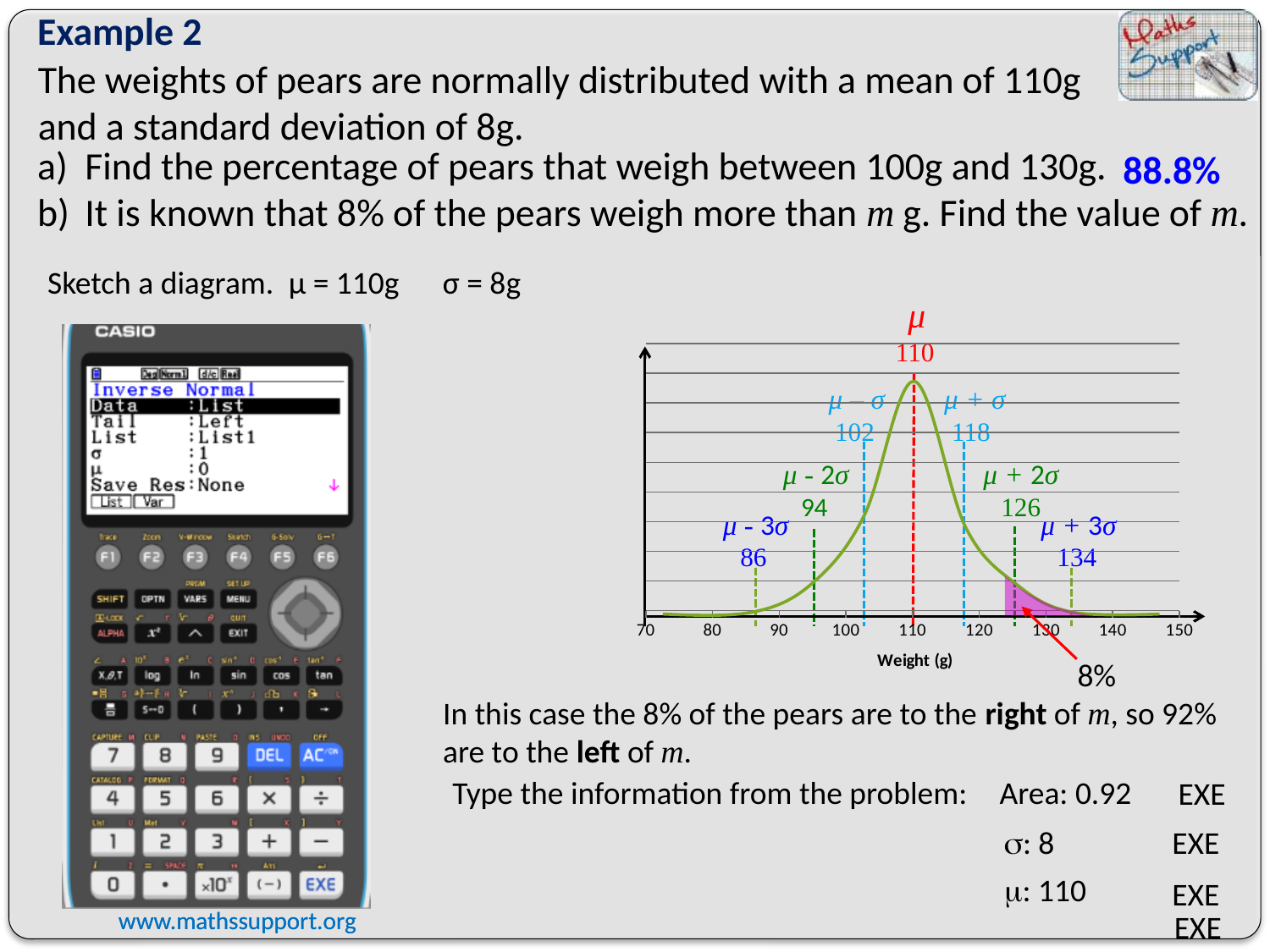
What value is marked at μ + 3σ on the chart? 134 What percentage is the shaded region under the curve labelled with? 8% What value is marked at μ − σ on the chart? 102 What value is marked at μ + σ on the chart? 118 What value is marked at μ on the normal distribution chart? 110 On which side of the curve is the shaded 8% region located? the right tail What value is marked at μ − 2σ on the chart? 94 How many labelled points (μ, μ ± σ, μ ± 2σ, μ ± 3σ) are marked on the chart? 7 What is the difference between the values marked at μ + σ and μ − σ? 16 What is the label on the x-axis of the chart? Weight (g) What value is marked at μ − 3σ on the chart? 86 Which is larger, the value marked at μ + 2σ or at μ − 2σ? μ + 2σ (126)